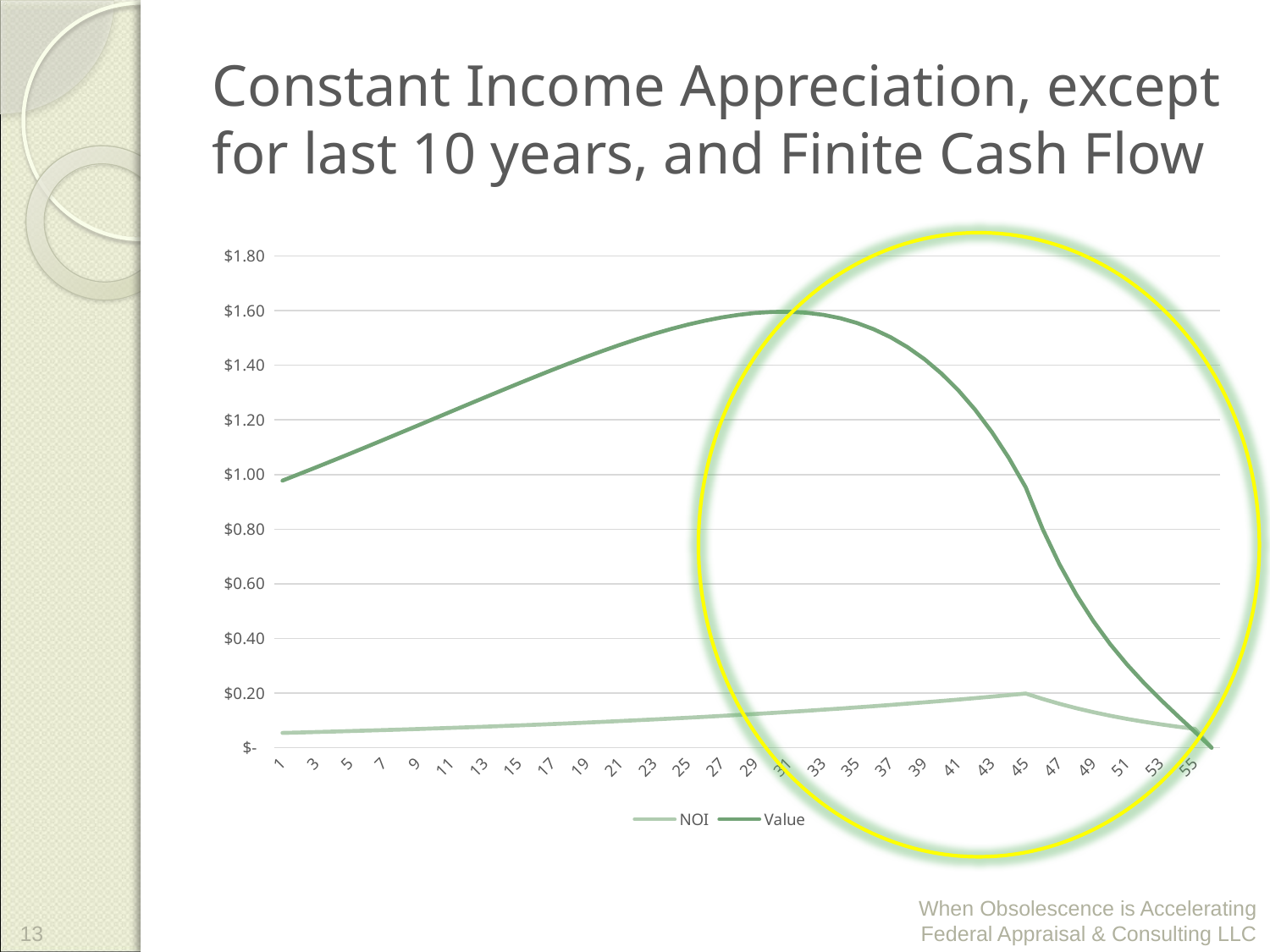
At x = 31, which series has the larger value, NOI or Value? Value Does the Value series rise or fall between x = 1 and x = 21? rise What is the title of the slide containing the chart? Constant Income Appreciation, except for last 10 years, and Finite Cash Flow How many series does the chart's legend list? 2 Is the Value series at x = 37 greater or less than $1.40? greater Is the Value series at x = 51 greater or less than $0.40? less Is the Value series at x = 15 greater or less than $1.20? greater Does the Value series rise or fall between x = 41 and x = 55? fall What kind of chart is shown on the slide? line chart What are the two series named in the chart's legend? NOI and Value